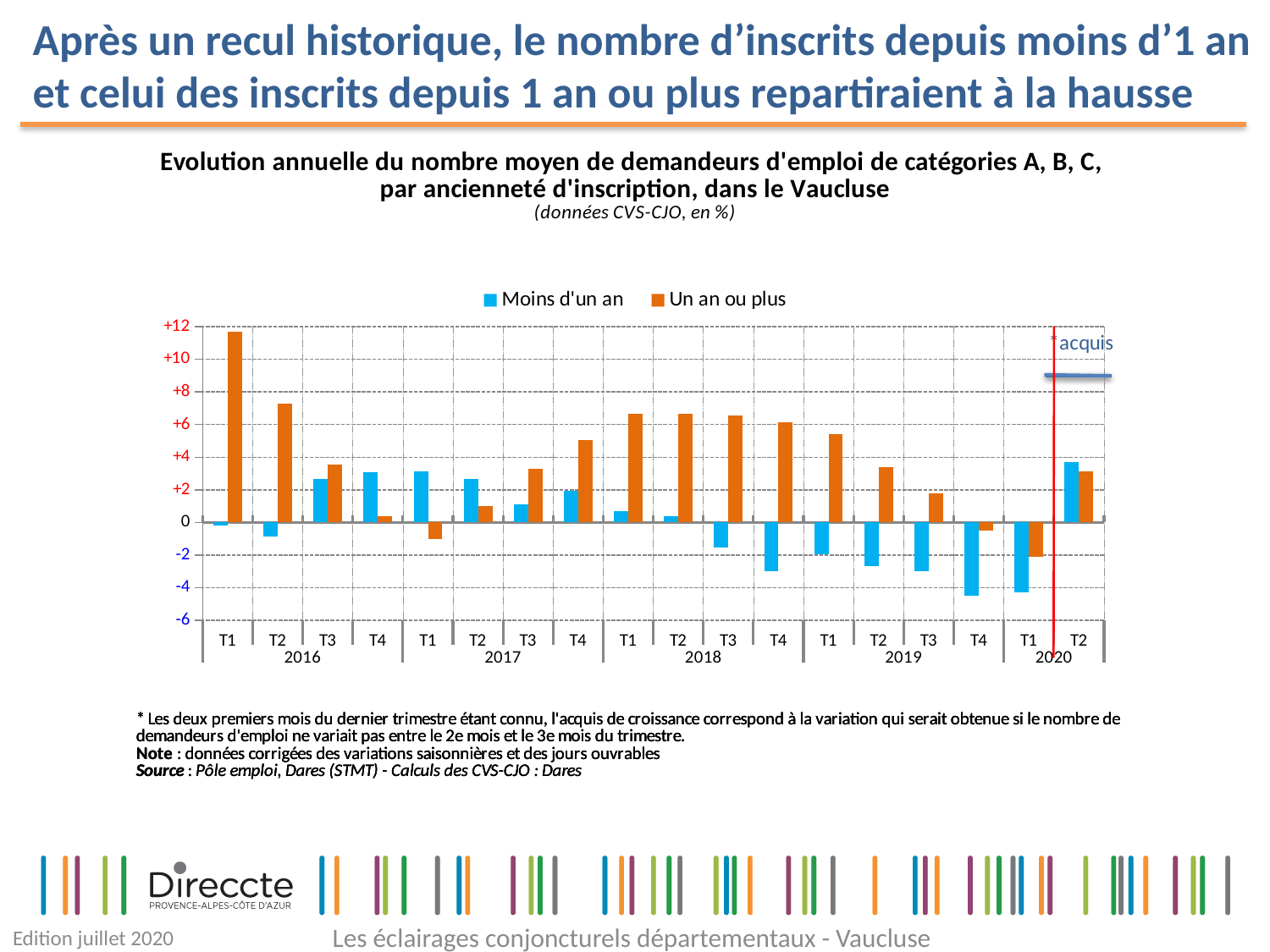
How many series does the legend list? 2 Is the value for 'Un an ou plus' in T1 2018 greater or less than +6? greater In T1 2017, which series has the larger value, 'Moins d'un an' or 'Un an ou plus'? Moins d'un an Which colour represents the 'Moins d'un an' series in the legend? Blue Is the value for 'Un an ou plus' in T1 2016 greater or less than +10? greater In which quarter is the value for 'Un an ou plus' the lowest? T1 2020 Is the value for 'Moins d'un an' in T4 2019 greater or less than -4? less How many quarters (bar groups) are plotted along the x axis? 18 Do the values for 'Un an ou plus' rise or fall from T1 2018 to T1 2020? fall In which quarter is the value for 'Un an ou plus' the highest? T1 2016 What kind of chart is shown on the slide? Bar chart